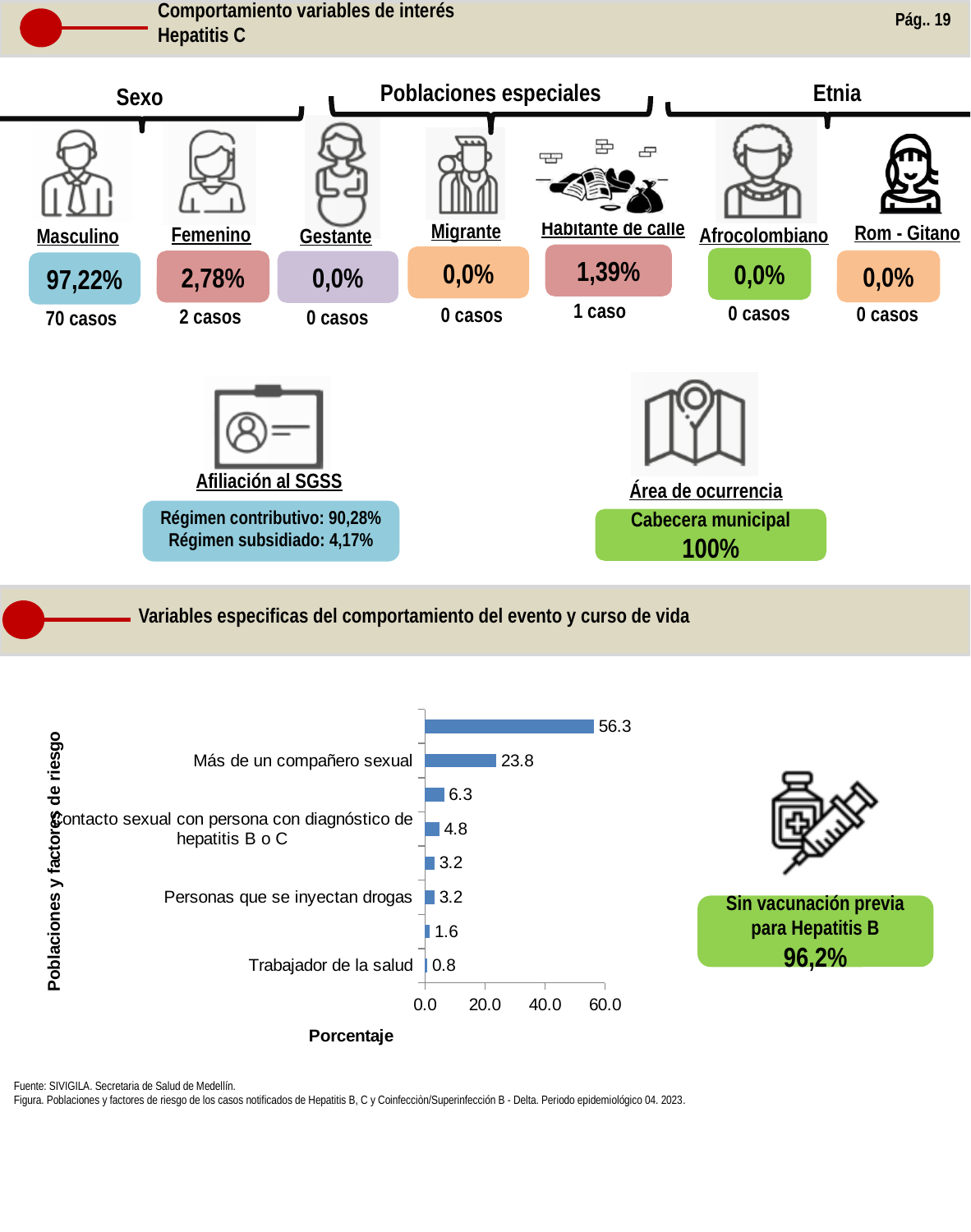
What is the value for "Contacto sexual con persona con diagnóstico de hepatitis B o C"? 4.8 Which is larger: the value for "Personas que se inyectan drogas" or the value for "Trabajador de la salud"? Personas que se inyectan drogas How many bars are plotted in the bar chart? 8 What is the value for "Más de un compañero sexual"? 23.8 What is the value for "Trabajador de la salud"? 0.8 What is the difference between the values for "Más de un compañero sexual" and "Contacto sexual con persona con diagnóstico de hepatitis B o C"? 19.0 Is the value for "Más de un compañero sexual" greater or less than 20.0? greater What kind of chart is shown at the bottom of the slide? bar chart Which labelled category has the lowest value in the bar chart? Trabajador de la salud What is the value for "Personas que se inyectan drogas"? 3.2 What is the largest value shown in the bar chart? 56.3 What is the title of the horizontal axis of the bar chart? Porcentaje